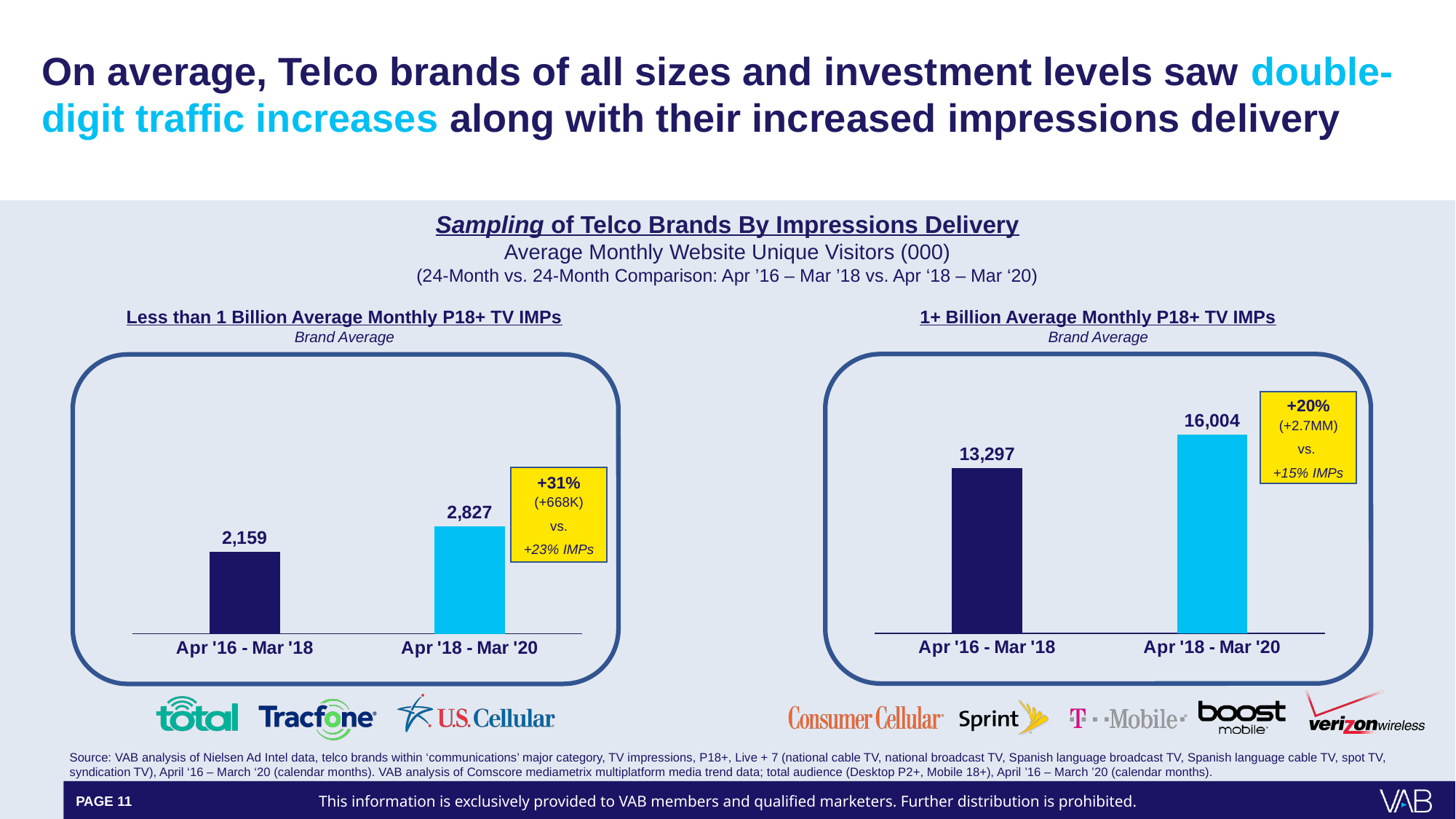
In the 'Less than 1 Billion Average Monthly P18+ TV IMPs' chart, do the values rise or fall from Apr '16 - Mar '18 to Apr '18 - Mar '20? rise In the '1+ Billion Average Monthly P18+ TV IMPs' chart, what percentage increase is shown in the yellow callout box? +20% In the 'Less than 1 Billion Average Monthly P18+ TV IMPs' chart, what is the value for Apr '18 - Mar '20? 2,827 In the 'Less than 1 Billion Average Monthly P18+ TV IMPs' chart, which period has the lower value? Apr '16 - Mar '18 What kind of chart is the '1+ Billion Average Monthly P18+ TV IMPs' chart? bar chart In the '1+ Billion Average Monthly P18+ TV IMPs' chart, what is the value for Apr '16 - Mar '18? 13,297 How many bars are in the 'Less than 1 Billion Average Monthly P18+ TV IMPs' chart? 2 In the '1+ Billion Average Monthly P18+ TV IMPs' chart, what is the difference between the Apr '18 - Mar '20 value and the Apr '16 - Mar '18 value? 2,707 In the 'Less than 1 Billion Average Monthly P18+ TV IMPs' chart, what is the difference between the Apr '18 - Mar '20 value and the Apr '16 - Mar '18 value? 668 In the '1+ Billion Average Monthly P18+ TV IMPs' chart, which period has the higher value? Apr '18 - Mar '20 In the 'Less than 1 Billion Average Monthly P18+ TV IMPs' chart, what is the value for Apr '16 - Mar '18? 2,159 In the '1+ Billion Average Monthly P18+ TV IMPs' chart, what is the value for Apr '18 - Mar '20? 16,004